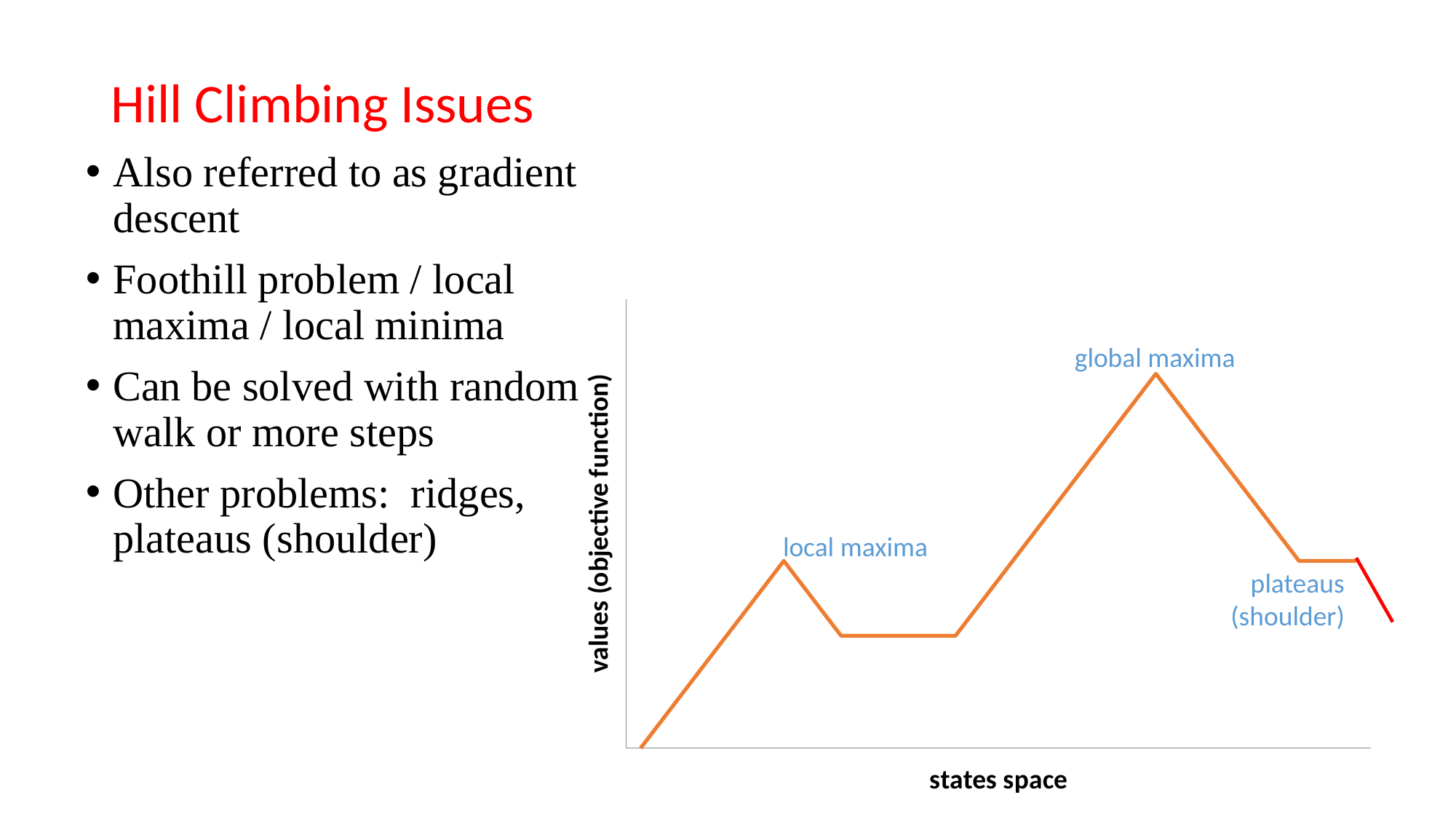
Does the line rise or fall from the start of the x axis up to the point labeled "local maxima"? rise How many labeled features (annotations) are marked on the line in the chart? 3 What is the title of the vertical axis of the chart? values (objective function) What kind of chart is shown on the slide? line chart Is the point labeled "global maxima" higher or lower than the point labeled "local maxima"? higher Does the line rise or fall immediately after the point labeled "global maxima"? fall Which labeled point on the chart is the highest? global maxima What is the title of the horizontal axis of the chart? states space